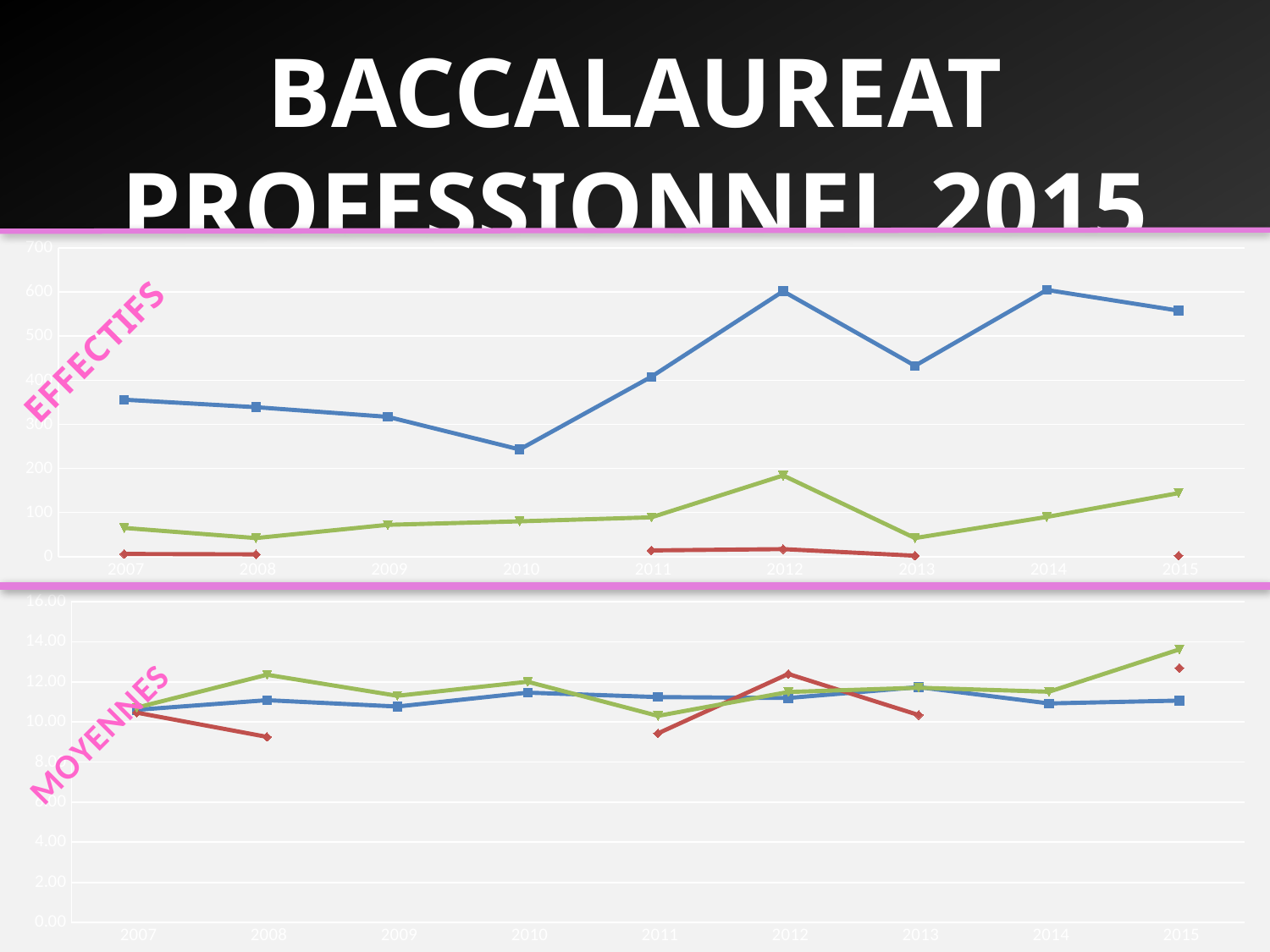
What kind of chart is the top chart labelled EFFECTIFS? line chart How many years are shown on the x axis of the top chart labelled EFFECTIFS? 9 In the top chart labelled EFFECTIFS, is the value of the blue line in 2012 greater or less than 500? greater In the top chart labelled EFFECTIFS, does the blue line rise or fall from 2007 to 2010? fall In the bottom chart labelled MOYENNES, is the value of the red line in 2008 greater or less than 10.00? less In the top chart labelled EFFECTIFS, in which year does the green line reach its highest value? 2012 In the bottom chart labelled MOYENNES, in which year does the green line reach its highest value? 2015 In the top chart labelled EFFECTIFS, in which year is the blue line at its lowest? 2010 In the bottom chart labelled MOYENNES, is the value of the green line in 2015 greater or less than 12.00? greater What is the pink label written beside the bottom chart? MOYENNES In the top chart labelled EFFECTIFS, which line is higher in 2015, the blue line or the green line? the blue line